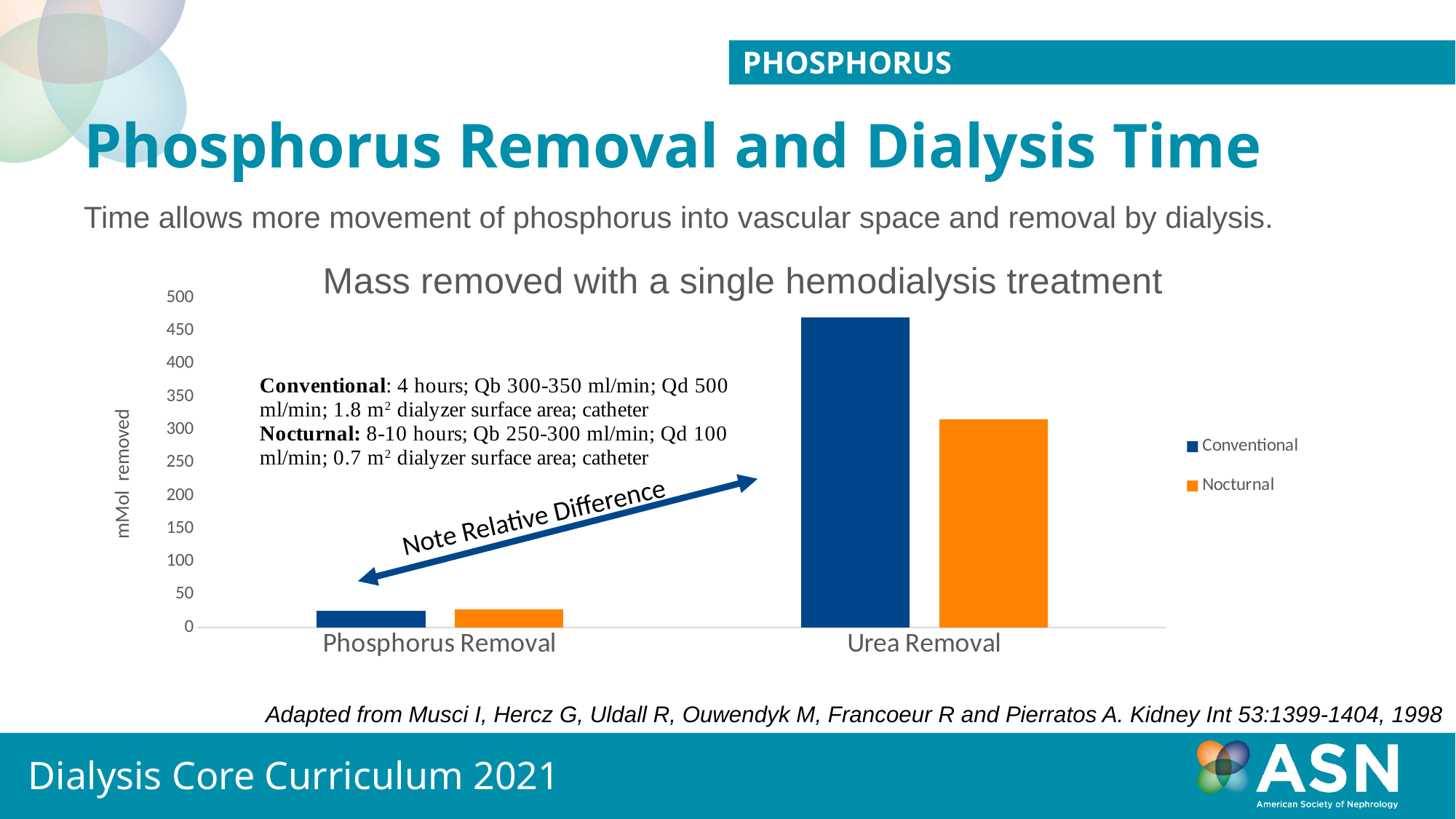
Is the Conventional value for Phosphorus Removal greater or less than 50? less For Urea Removal, which series has the larger value, Conventional or Nocturnal? Conventional What is the label on the vertical axis of the chart? mMol removed How many series does the chart legend list? 2 Is the Nocturnal value for Urea Removal greater or less than 350? less What kind of chart is shown on the slide? bar chart What is the title of the chart? Mass removed with a single hemodialysis treatment Is the Conventional value for Urea Removal greater or less than 400? greater Which category and series has the highest bar in the chart? Urea Removal, Conventional Which category has the larger Conventional value, Phosphorus Removal or Urea Removal? Urea Removal How many categories are shown on the x axis of the chart? 2